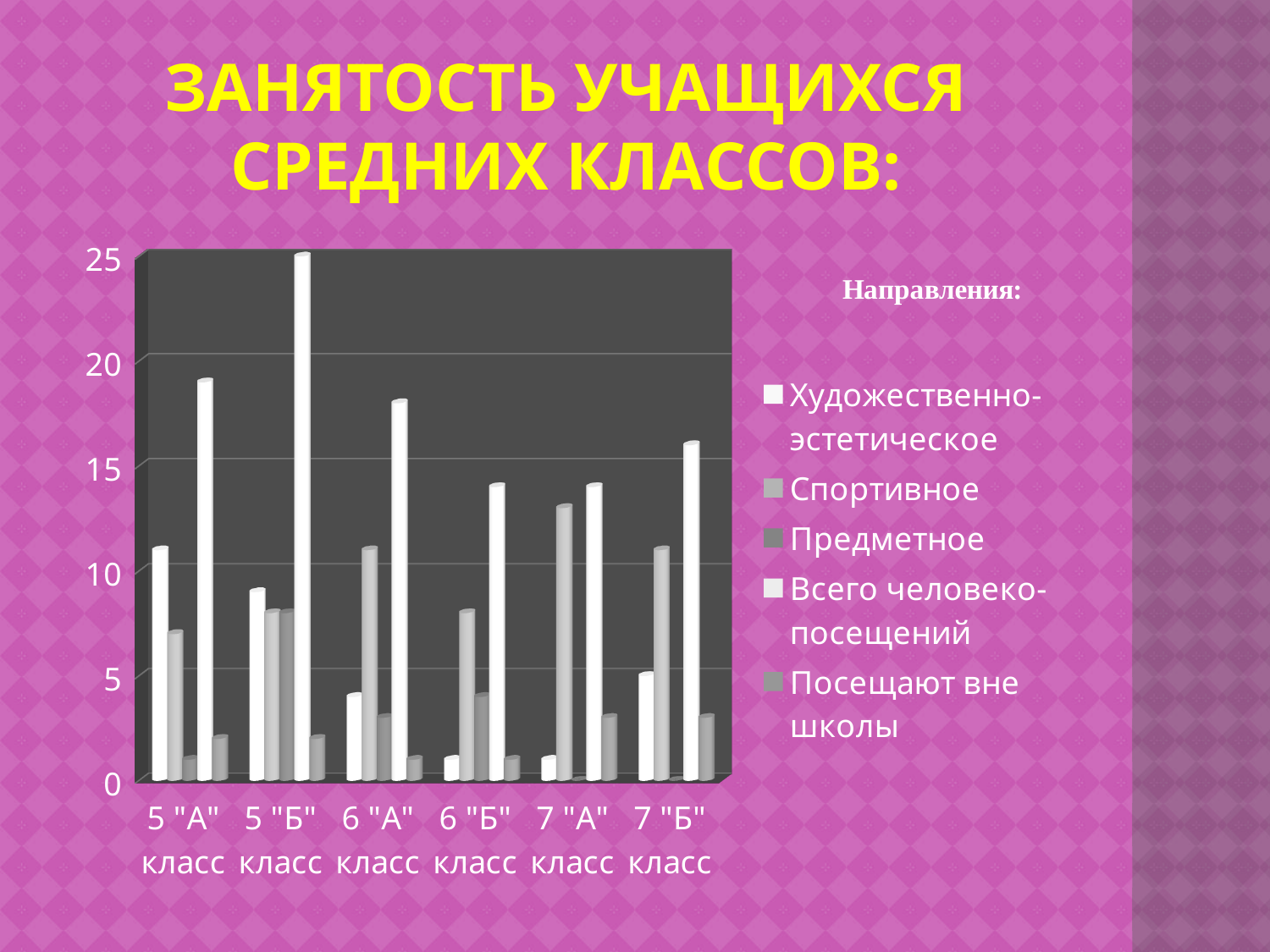
Is the value of "Художественно-эстетическое" for 6 "Б" класс greater or less than 5? less What kind of chart is shown on the slide? bar chart Is the value of "Художественно-эстетическое" for 5 "А" класс greater or less than 5? greater Which is larger: the value of "Всего человеко-посещений" for 5 "Б" класс or for 6 "А" класс? 5 "Б" класс How many classes (categories) are shown on the x axis of the chart? 6 Is the value of "Всего человеко-посещений" for 5 "Б" класс greater or less than 20? greater How many series does the chart legend list? 5 What is the heading shown above the chart legend? Направления: Which class has the highest value for "Всего человеко-посещений"? 5 "Б" класс Which is larger: the value of "Спортивное" for 7 "А" класс or for 5 "А" класс? 7 "А" класс